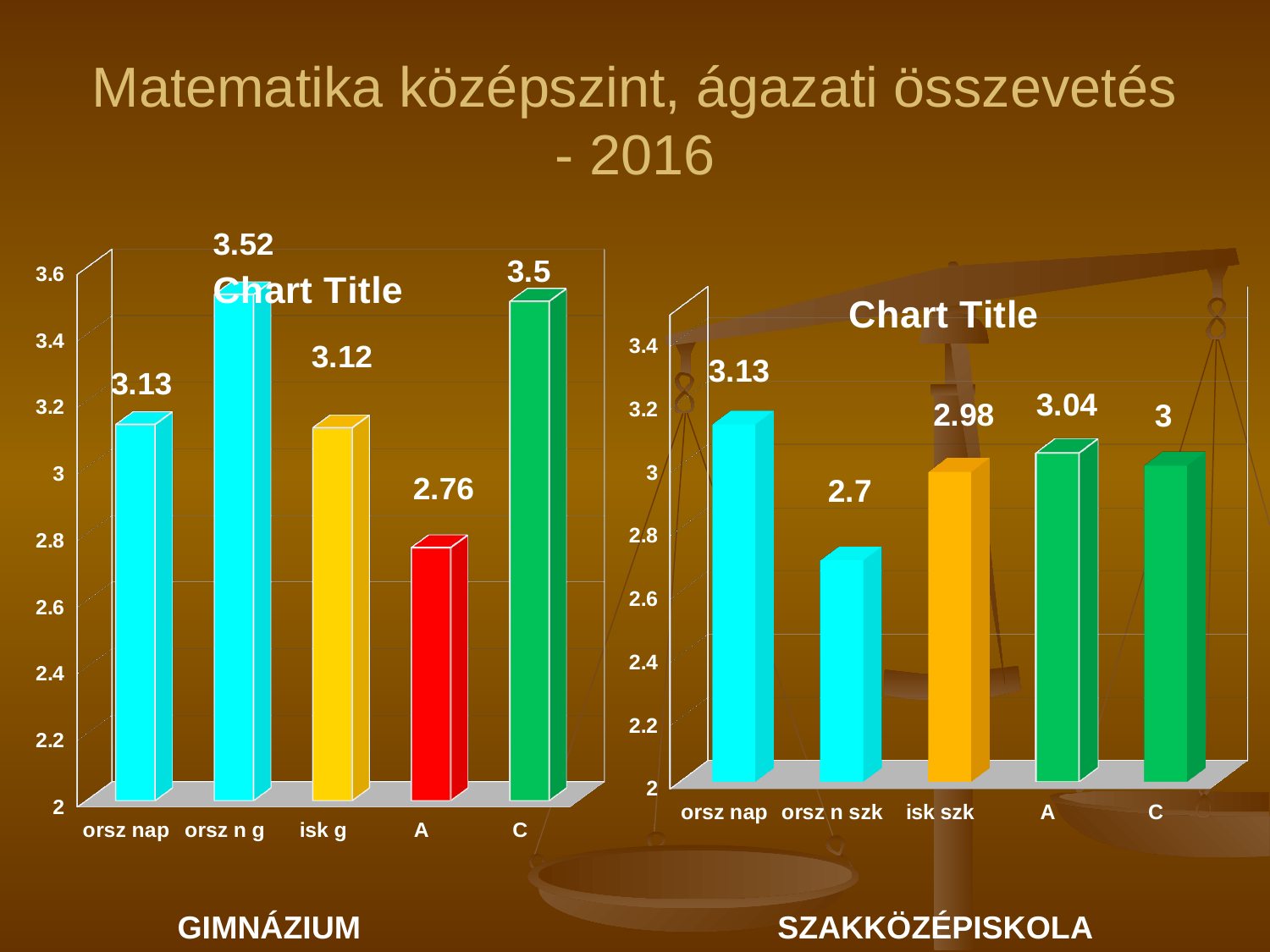
In the right chart (SZAKKÖZÉPISKOLA), what is the value for isk szk? 2.98 In the left chart (GIMNÁZIUM), which category has the highest value? orsz n g In the left chart (GIMNÁZIUM), what is the difference between the values for orsz n g and A? 0.76 In the right chart (SZAKKÖZÉPISKOLA), what is the value for orsz n szk? 2.7 In the right chart (SZAKKÖZÉPISKOLA), which is larger, the value for A or the value for orsz n szk? A How many categories are shown in the right chart (SZAKKÖZÉPISKOLA)? 5 In the left chart (GIMNÁZIUM), what is the value for A? 2.76 In the left chart (GIMNÁZIUM), what is the value for orsz n g? 3.52 In the right chart (SZAKKÖZÉPISKOLA), which category has the lowest value? orsz n szk In the right chart (SZAKKÖZÉPISKOLA), which category has the highest value? orsz nap In the left chart (GIMNÁZIUM), which category has the lowest value? A What kind of chart is the left chart (GIMNÁZIUM)? bar chart